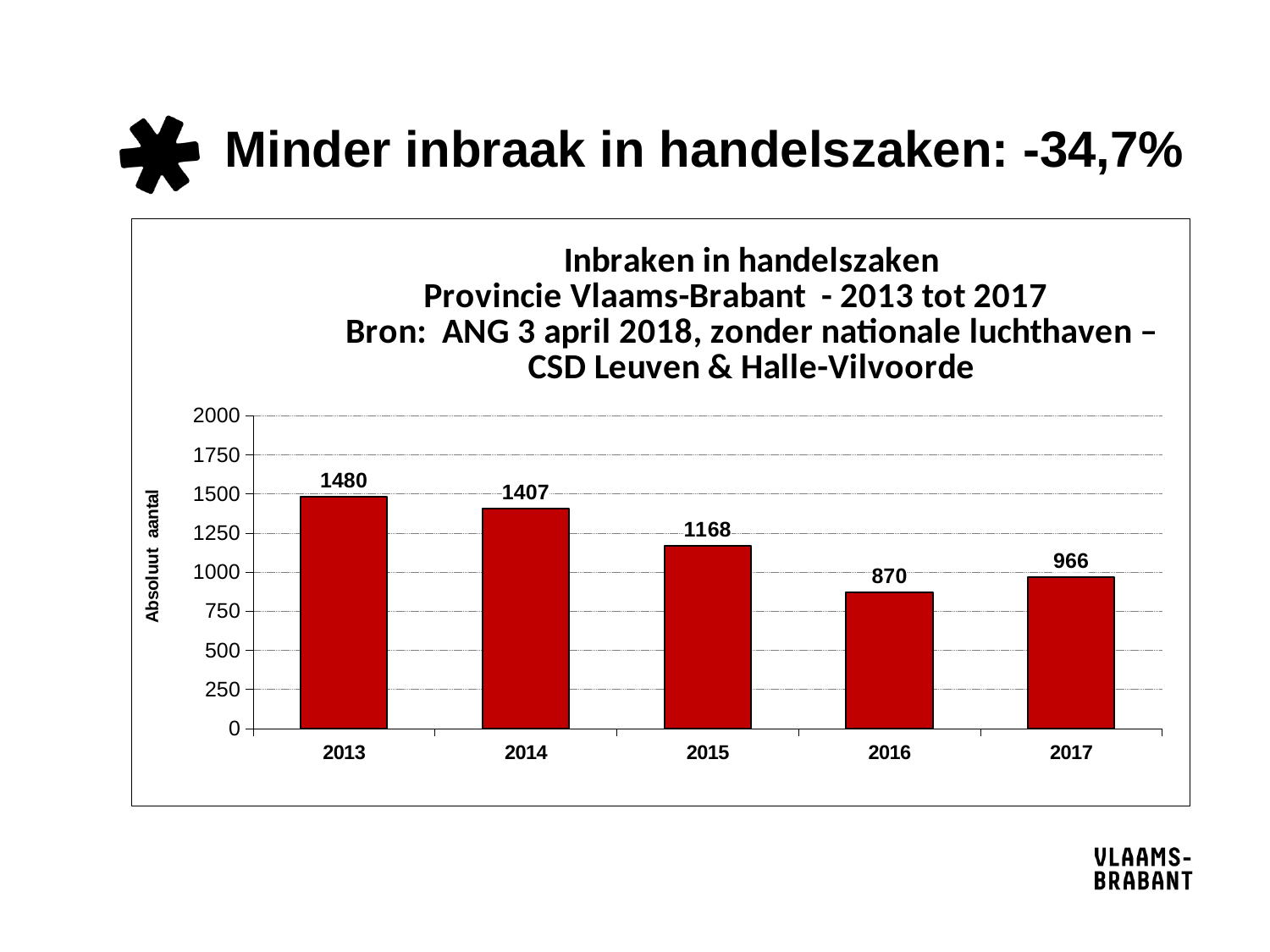
Is the value for 2015 greater or less than 1000? greater What kind of chart is shown? bar chart Which year has the lowest value? 2016 What is the difference between the values for 2014 and 2015? 239 Which is larger, the value for 2016 or the value for 2017? 2017 What is the value for 2013? 1480 What is the difference between the values for 2013 and 2017? 514 What is the value for 2016? 870 Which year has the highest value? 2013 What is the label of the y axis? Absoluut aantal What is the value for 2017? 966 How many years are shown on the x axis? 5